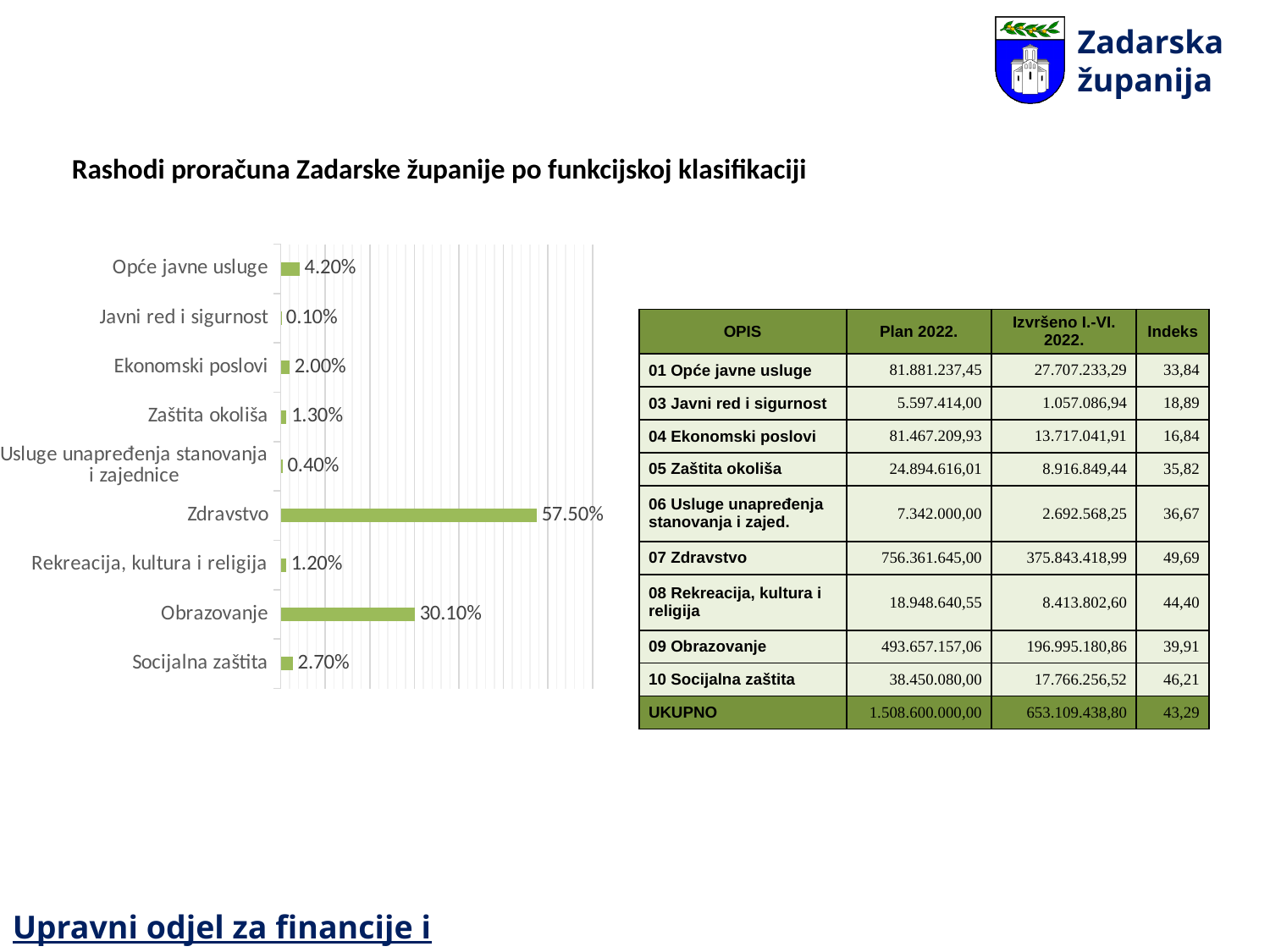
How many categories are shown in the bar chart? 9 What is the value for Socijalna zaštita in the bar chart? 2.70% Which is larger in the bar chart, Zaštita okoliša or Rekreacija, kultura i religija? Zaštita okoliša What is the value for Opće javne usluge in the bar chart? 4.20% Which category has the highest value in the bar chart? Zdravstvo What is the value for Zdravstvo in the bar chart? 57.50% What is the value for Usluge unapređenja stanovanja i zajednice in the bar chart? 0.40% What is the difference between the values for Zdravstvo and Obrazovanje in the bar chart? 27.40% Which category has the lowest value in the bar chart? Javni red i sigurnost What is the difference between the values for Opće javne usluge and Ekonomski poslovi in the bar chart? 2.20% What type of chart is shown on the slide? Bar chart What is the value for Obrazovanje in the bar chart? 30.10%